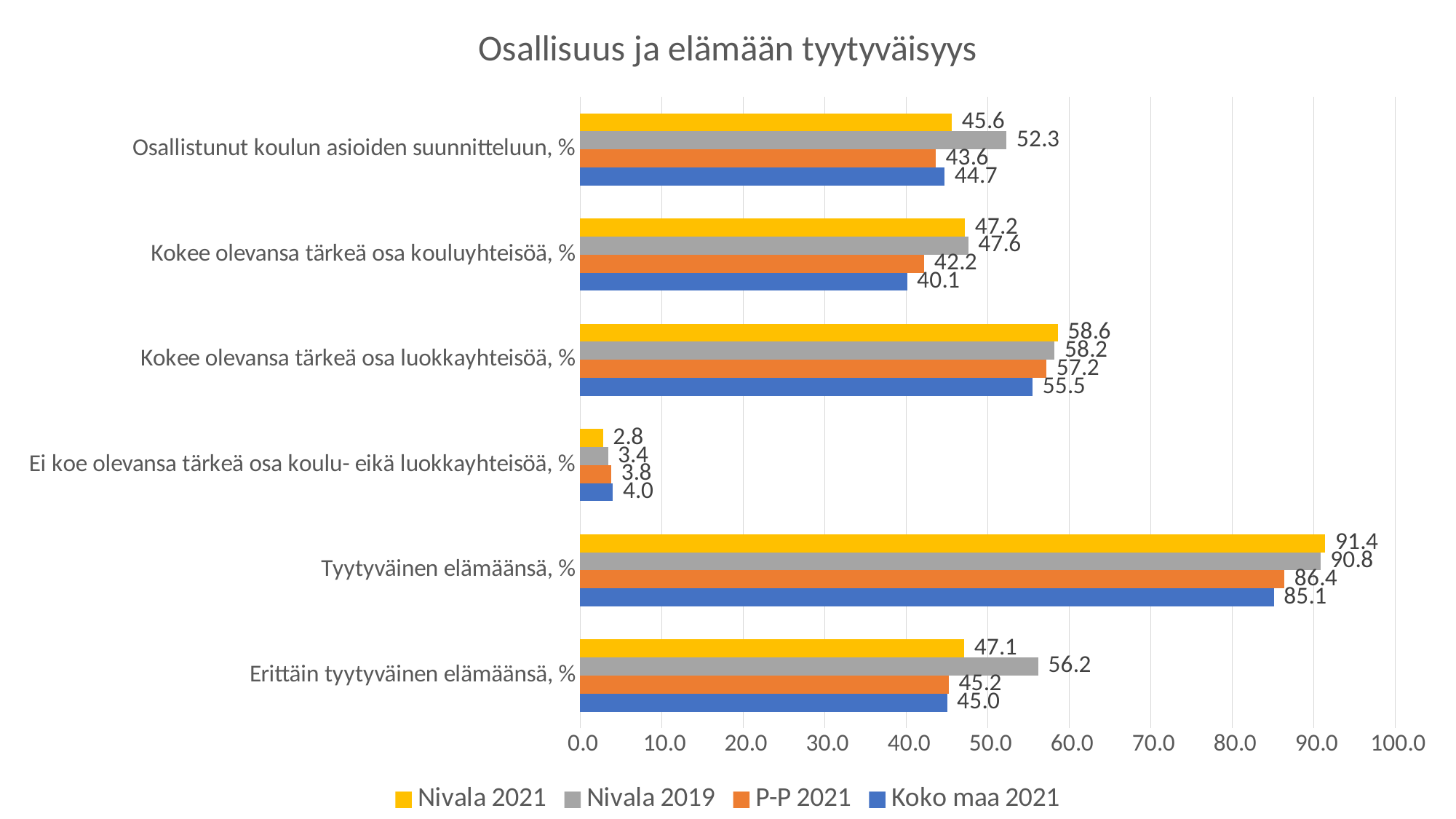
What is the value for Nivala 2021 in the category "Tyytyväinen elämäänsä, %"? 91.4 What is the value for Koko maa 2021 in the category "Kokee olevansa tärkeä osa kouluyhteisöä, %"? 40.1 Which category has the highest value for Nivala 2021? Tyytyväinen elämäänsä, % What is the value for Nivala 2019 in the category "Erittäin tyytyväinen elämäänsä, %"? 56.2 What is the difference between Nivala 2019 and Nivala 2021 in the category "Erittäin tyytyväinen elämäänsä, %"? 9.1 What is the title of the chart? Osallisuus ja elämään tyytyväisyys How many categories are shown on the chart? 6 What is the value for P-P 2021 in the category "Osallistunut koulun asioiden suunnitteluun, %"? 43.6 Which category has the lowest value for Koko maa 2021? Ei koe olevansa tärkeä osa koulu- eikä luokkayhteisöä, % In the category "Osallistunut koulun asioiden suunnitteluun, %", which is larger: Nivala 2019 or Nivala 2021? Nivala 2019 What kind of chart is shown on the slide? Bar chart How many series does the legend list? 4